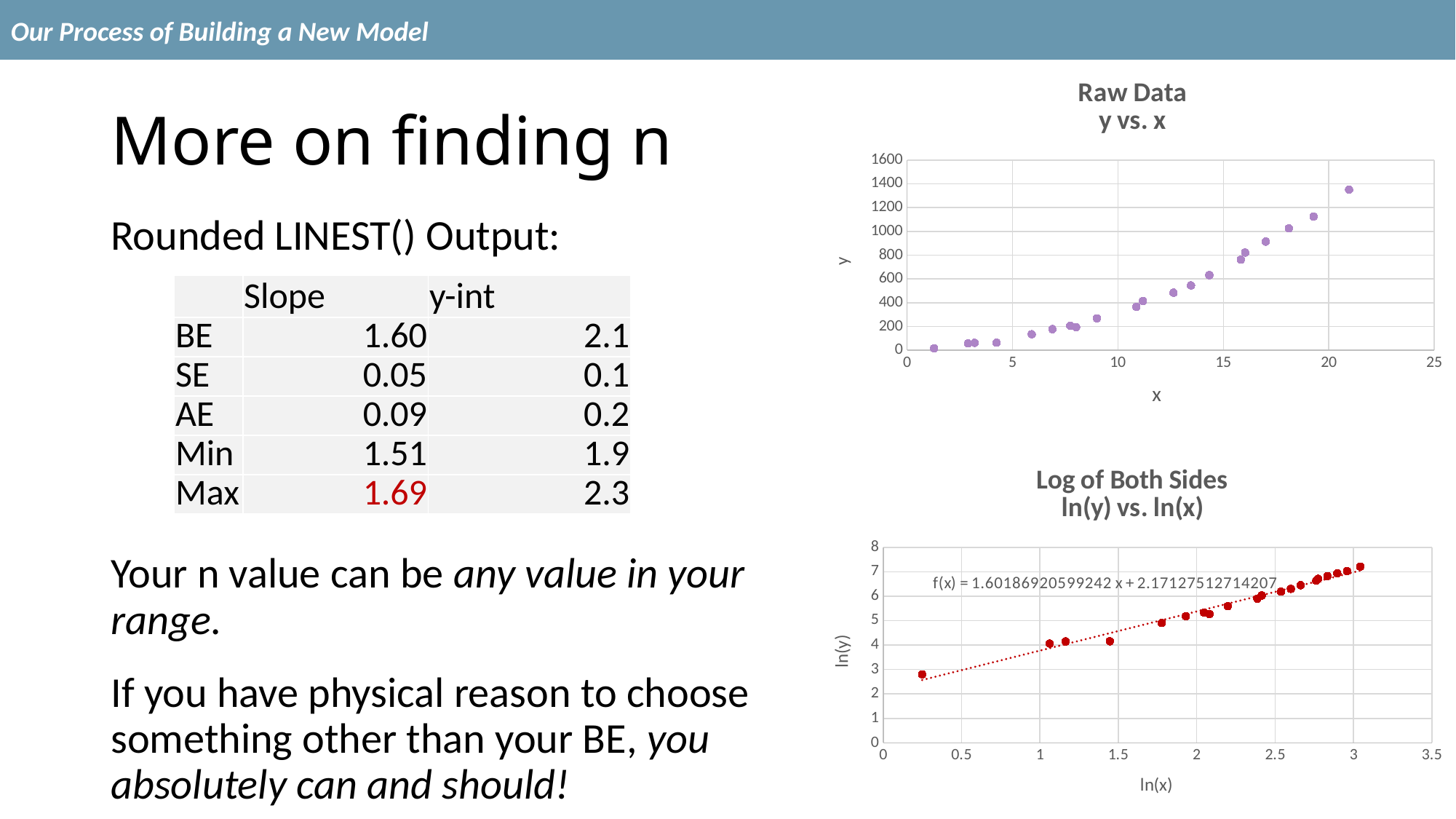
In the 'Raw Data y vs. x' chart, is the y value of the leftmost point greater or less than 200? less What kind of chart is the 'Raw Data y vs. x' chart? scatter chart What kind of chart is the 'Log of Both Sides ln(y) vs. ln(x)' chart? scatter chart In the 'Raw Data y vs. x' chart, which has the larger y value, the rightmost point or the leftmost point? the rightmost point In the 'Raw Data y vs. x' chart, do the y values rise or fall as x increases? rise In the 'Log of Both Sides ln(y) vs. ln(x)' chart, is the ln(y) value of the leftmost point greater or less than 4? less In the 'Log of Both Sides ln(y) vs. ln(x)' chart, is the ln(y) value of the rightmost point greater or less than 6? greater In the 'Log of Both Sides ln(y) vs. ln(x)' chart, do the ln(y) values rise or fall as ln(x) increases? rise What is the x-axis label of the 'Log of Both Sides ln(y) vs. ln(x)' chart? ln(x) What is the trendline equation shown on the 'Log of Both Sides ln(y) vs. ln(x)' chart? f(x) = 1.60186920599242 x + 2.17127512714207